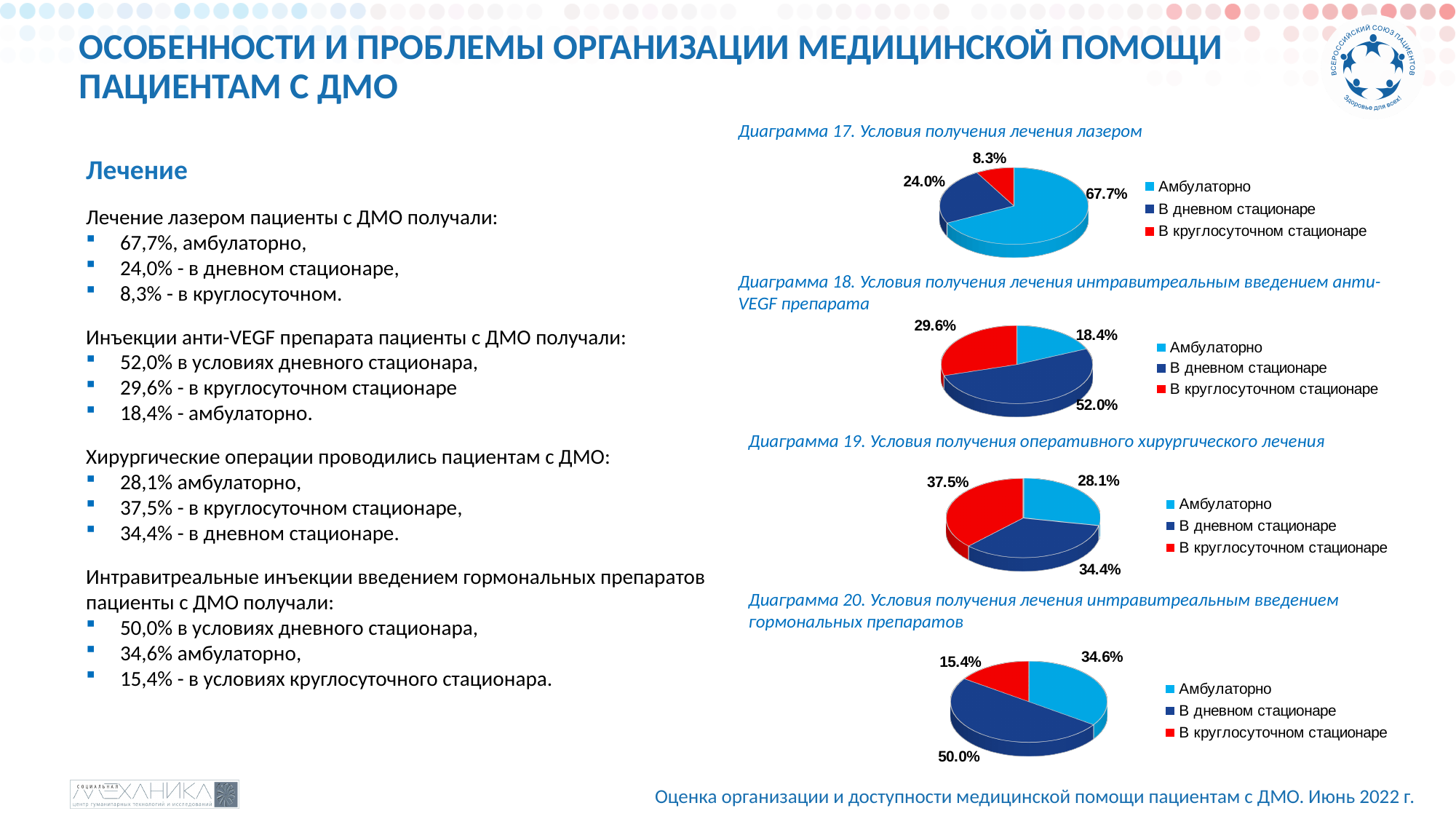
In Диаграмма 17 (Условия получения лечения лазером), which category has the smallest slice? В круглосуточном стационаре In Диаграмма 19 (Условия получения оперативного хирургического лечения), which is larger: Амбулаторно or В дневном стационаре? В дневном стационаре In Диаграмма 18 (лечение интравитреальным введением анти-VEGF препарата), which category has the largest slice? В дневном стационаре In Диаграмма 20 (лечение интравитреальным введением гормональных препаратов), what is the value for В круглосуточном стационаре? 15.4% How many series does the legend of Диаграмма 19 (Условия получения оперативного хирургического лечения) list? 3 What type of chart is Диаграмма 17 (Условия получения лечения лазером)? Pie chart In Диаграмма 19 (Условия получения оперативного хирургического лечения), what is the value for В круглосуточном стационаре? 37.5% In Диаграмма 20 (лечение интравитреальным введением гормональных препаратов), what is the difference between В дневном стационаре and Амбулаторно? 15.4% How many pie charts are shown on the slide? 4 In Диаграмма 17 (Условия получения лечения лазером), what share is labelled for Амбулаторно? 67.7% In Диаграмма 18 (лечение интравитреальным введением анти-VEGF препарата), what is the value for В дневном стационаре? 52.0% In Диаграмма 18 (лечение интравитреальным введением анти-VEGF препарата), what is the difference between В круглосуточном стационаре and Амбулаторно? 11.2%